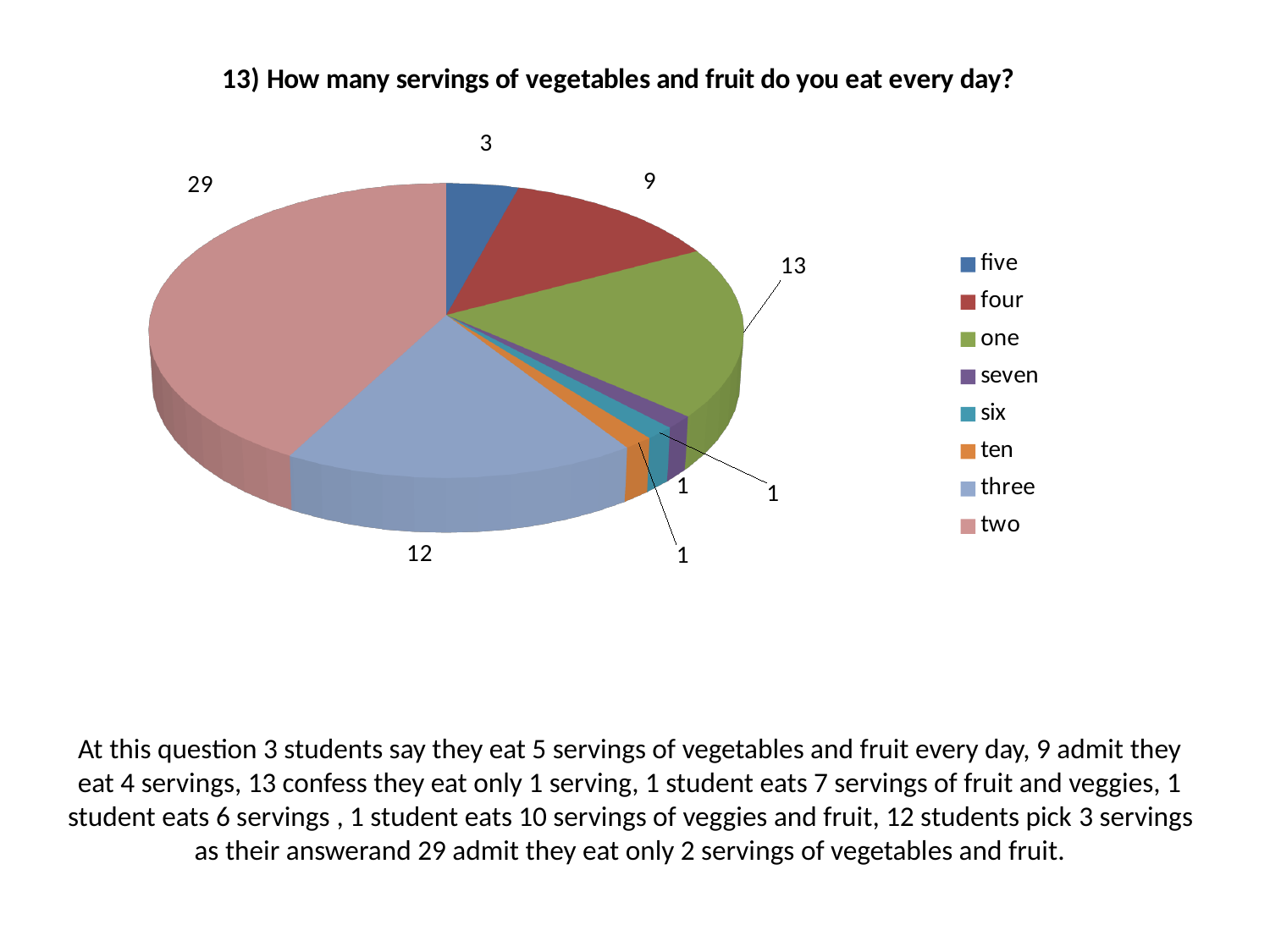
What is the difference between the values for "one" and "four"? 4 What is the difference between the values for "two" and "three"? 17 What is the value for the "two" slice? 29 What is the total of all the slice values in the pie chart? 69 Which is larger, the value for "three" or the value for "four"? three What is the value for the "one" slice? 13 What is the title of the chart? 13) How many servings of vegetables and fruit do you eat every day? What is the value for the "four" slice? 9 Which category has the largest slice of the pie? two How many categories does the legend list? 8 What kind of chart is shown on the slide? pie chart What is the value for the "five" slice? 3